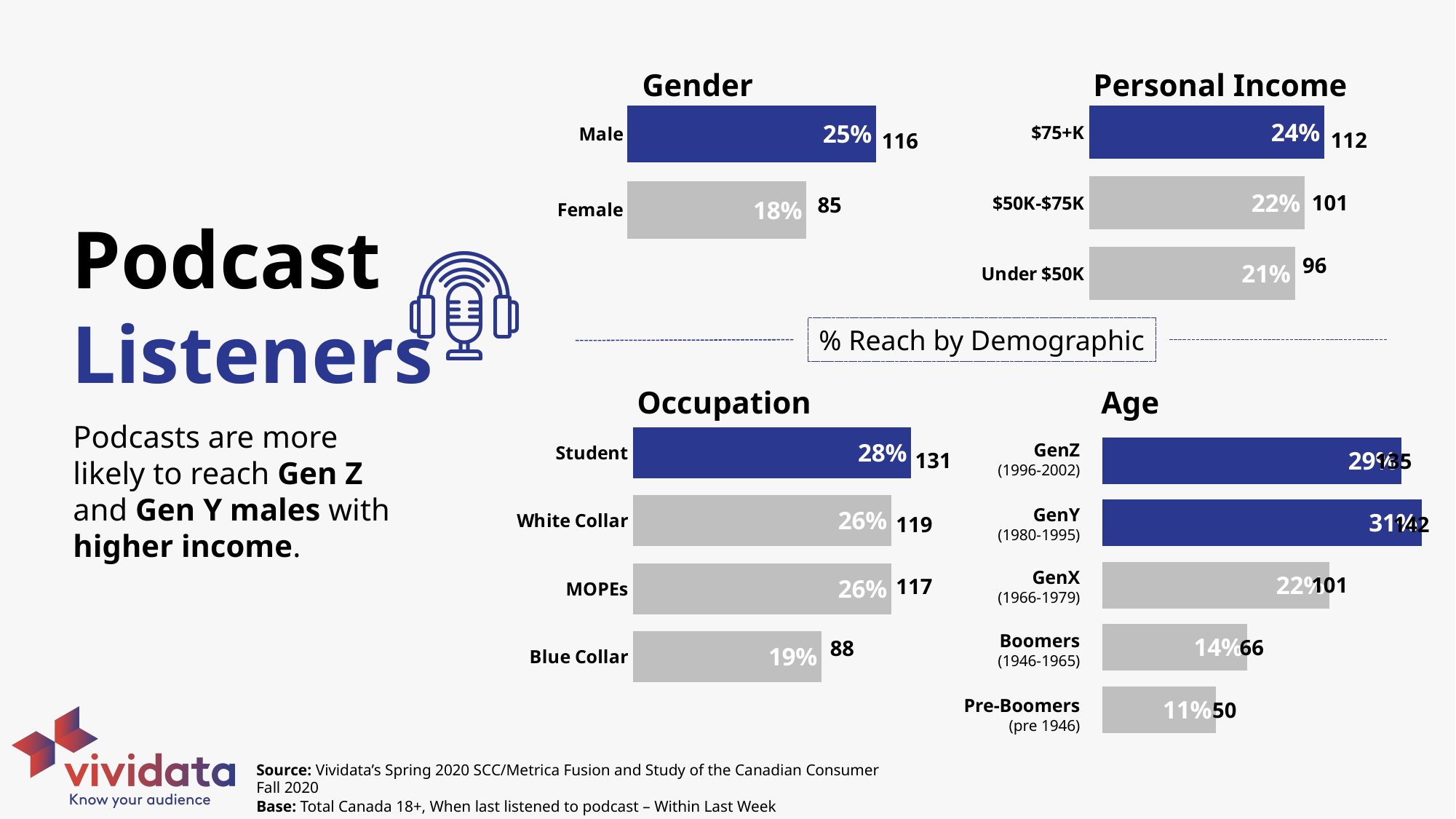
In the Occupation chart, how many occupation categories are shown? 4 In the Occupation chart, which has a higher % reach, Student or White Collar? Student What type of chart is used for the Personal Income data? Bar chart In the Personal Income chart, what is the % reach for Under $50K? 21% In the Occupation chart, what is the difference in % reach between Student and Blue Collar? 9 percentage points In the Age chart, which age group has the highest % reach? GenY In the Age chart, how many age groups are shown? 5 In the Gender chart, what is the % reach for Male? 25% In the Gender chart, what is the difference in % reach between Male and Female? 7 percentage points In the Personal Income chart, which income group has the highest % reach? $75+K In the Occupation chart, which occupation has the lowest % reach? Blue Collar In the Gender chart, what is the index number shown next to the Female bar? 85